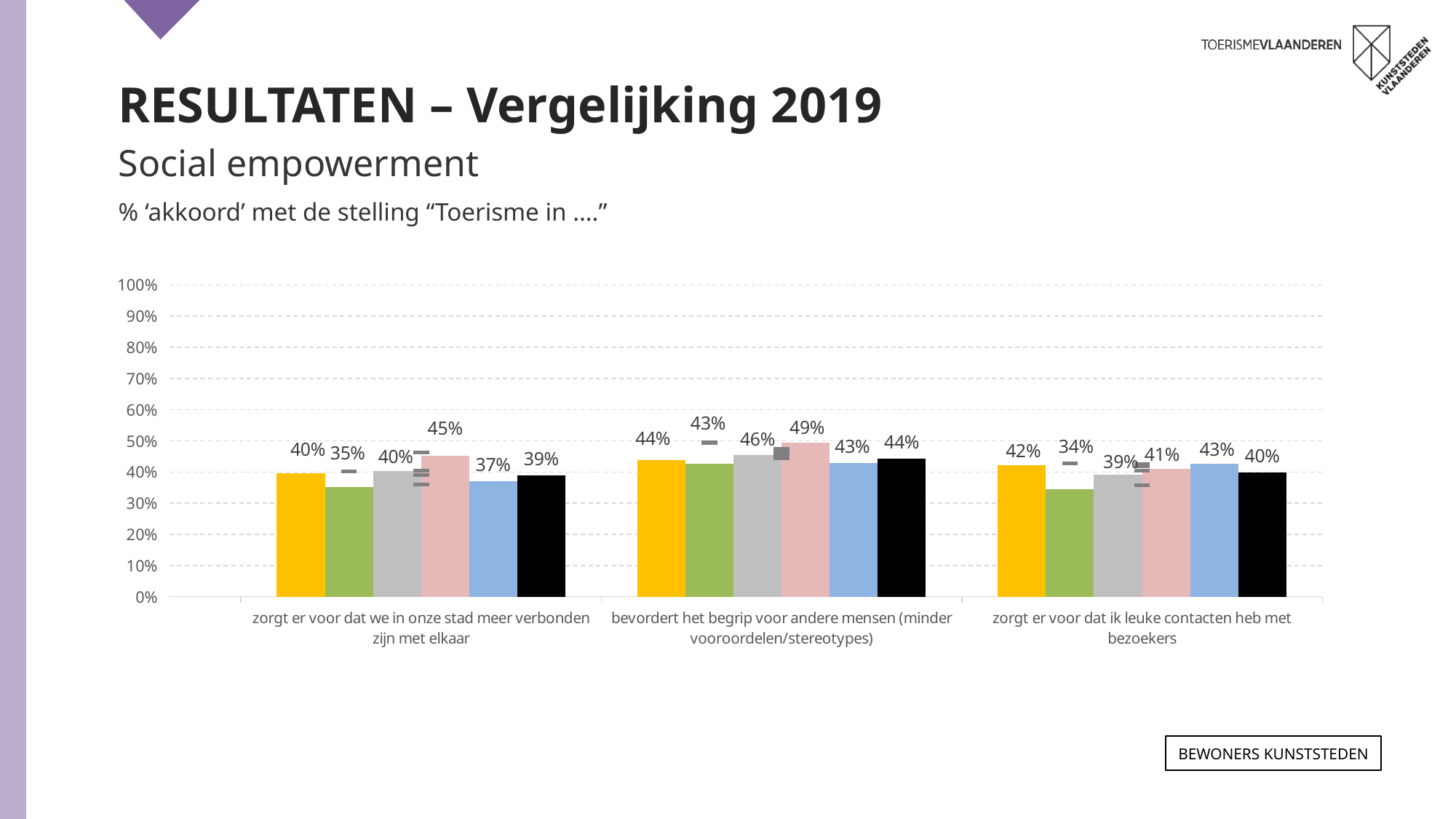
What is the value of the pink bar for the statement 'bevordert het begrip voor andere mensen (minder vooroordelen/stereotypes)'? 49% How many statement categories are shown on the x axis of the chart? 3 Is the value of the yellow bar for 'bevordert het begrip voor andere mensen (minder vooroordelen/stereotypes)' greater or less than 50%? less For the statement 'bevordert het begrip voor andere mensen (minder vooroordelen/stereotypes)', which is larger: the grey bar or the blue bar? the grey bar (46%) How many bars are plotted for each statement category in the chart? 6 What is the subtitle shown above the chart describing what the percentages represent? % ‘akkoord’ met de stelling “Toerisme in ….” What is the value of the black bar for the statement 'zorgt er voor dat we in onze stad meer verbonden zijn met elkaar'? 39% What is the difference between the pink bar and the green bar for the statement 'zorgt er voor dat we in onze stad meer verbonden zijn met elkaar'? 10% Which bar has the highest value for the statement 'zorgt er voor dat we in onze stad meer verbonden zijn met elkaar'? the pink bar (45%) What is the value of the green bar for the statement 'zorgt er voor dat ik leuke contacten heb met bezoekers'? 34% What type of chart is shown on the slide? bar chart Which bar has the lowest value for the statement 'zorgt er voor dat ik leuke contacten heb met bezoekers'? the green bar (34%)